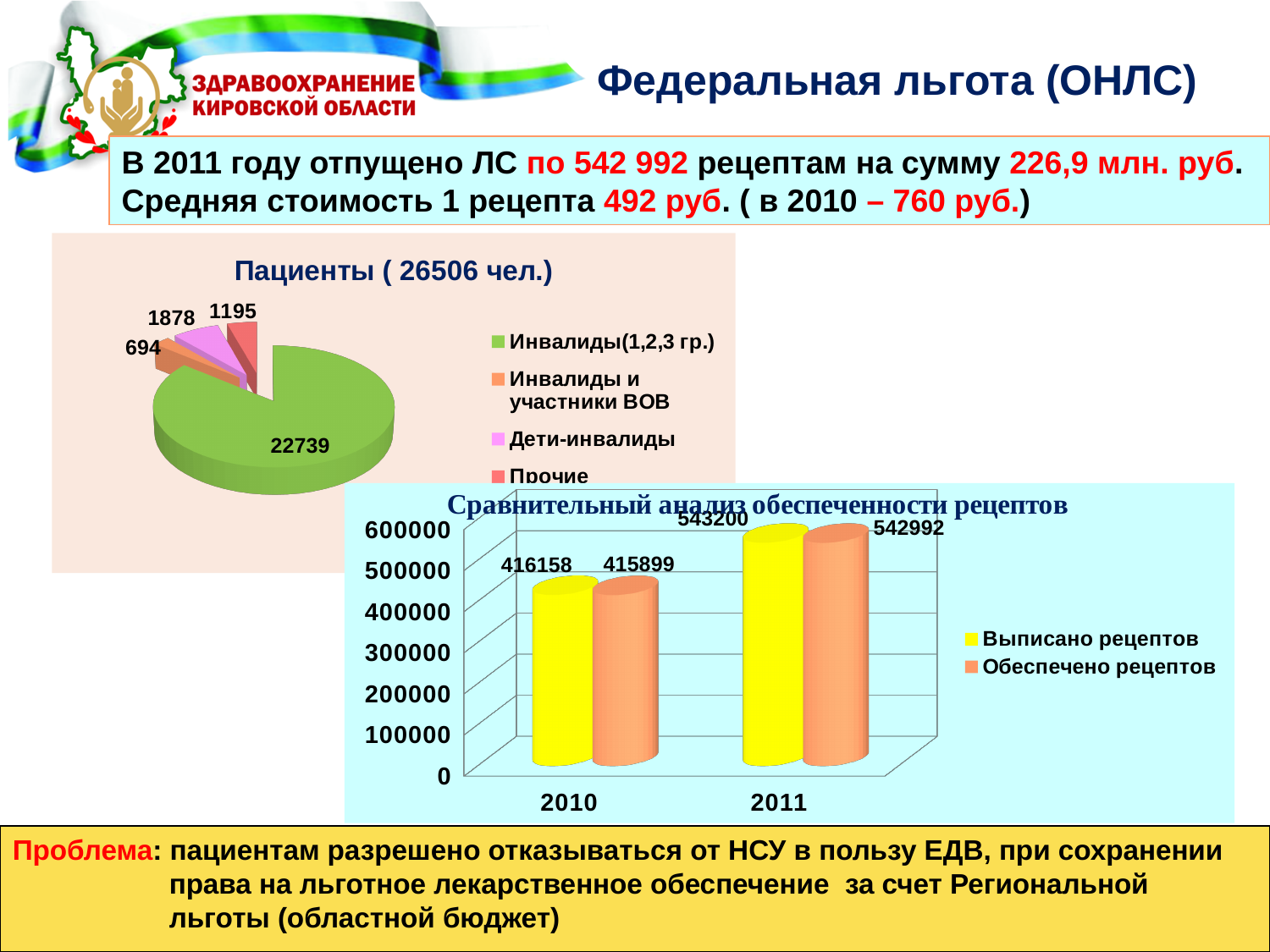
In the chart 'Сравнительный анализ обеспеченности рецептов', what is the difference between 'Выписано рецептов' and 'Обеспечено рецептов' in 2011? 208 In the pie chart 'Пациенты (26506 чел.)', what is the value for 'Дети-инвалиды'? 1878 In the chart 'Сравнительный анализ обеспеченности рецептов', what is the value of 'Обеспечено рецептов' for 2010? 415899 In the chart 'Сравнительный анализ обеспеченности рецептов', how many series does the legend list? 2 What type of chart is 'Пациенты (26506 чел.)'? Pie chart In the pie chart 'Пациенты (26506 чел.)', how many categories does the legend list? 4 In the pie chart 'Пациенты (26506 чел.)', what is the difference between the 'Дети-инвалиды' and 'Прочие' values? 683 In the chart 'Сравнительный анализ обеспеченности рецептов', does 'Выписано рецептов' rise or fall from 2010 to 2011? Rise What type of chart is 'Сравнительный анализ обеспеченности рецептов'? Bar chart In the pie chart 'Пациенты (26506 чел.)', which category has the smallest value? Инвалиды и участники ВОВ In the pie chart 'Пациенты (26506 чел.)', how many patients are in the 'Инвалиды(1,2,3 гр.)' category? 22739 In the chart 'Сравнительный анализ обеспеченности рецептов', what is the value of 'Выписано рецептов' for 2011? 543200